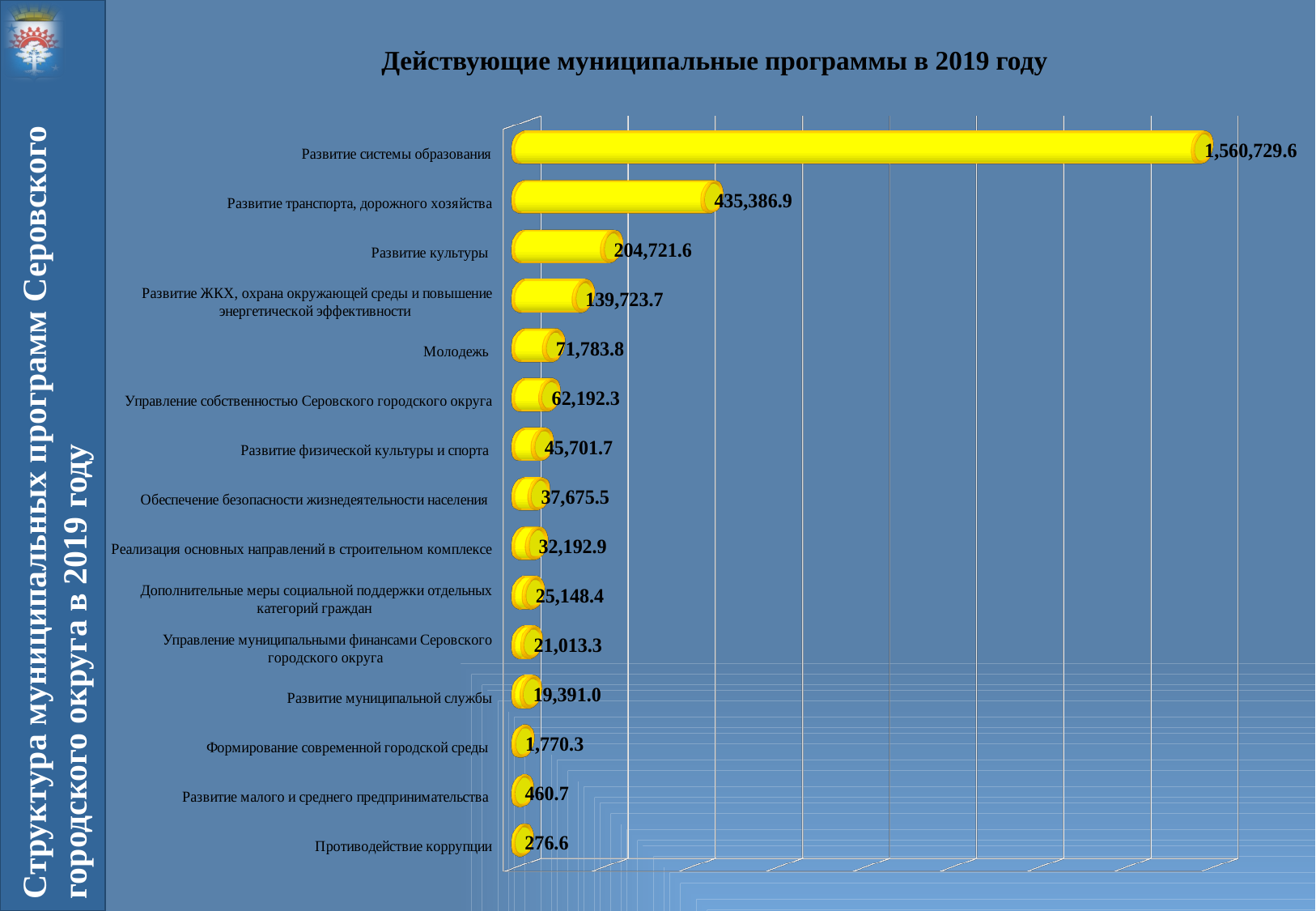
Which program has the highest value? Развитие системы образования What is the value for Развитие культуры? 204,721.6 What is the difference between Формирование современной городской среды and Развитие малого и среднего предпринимательства? 1,309.6 What is the difference between Развитие транспорта, дорожного хозяйства and Развитие культуры? 230,665.3 What is the value for Молодежь? 71,783.8 Which program has the lowest value? Противодействие коррупции What is the title of the chart? Действующие муниципальные программы в 2019 году What kind of chart is shown on the slide? Bar chart Which is larger: Развитие физической культуры и спорта or Обеспечение безопасности жизнедеятельности населения? Развитие физической культуры и спорта What is the value for Противодействие коррупции? 276.6 What is the value for Развитие системы образования? 1,560,729.6 How many programs are shown in the chart? 15